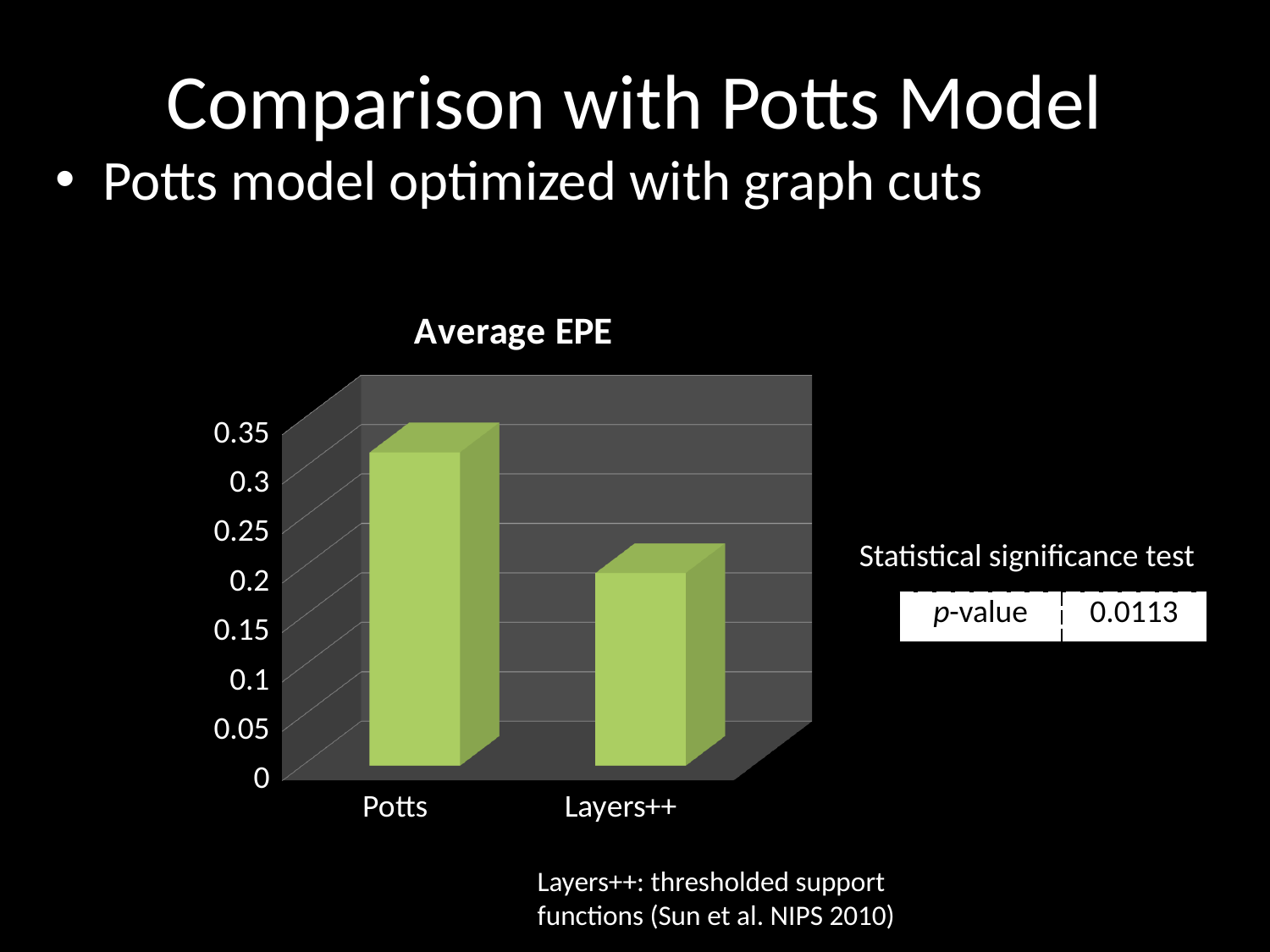
Which category has the lowest Average EPE? Layers++ What is the highest tick value shown on the vertical axis of the chart? 0.35 Is the Average EPE value for Layers++ greater or less than 0.15? greater Which category has the highest Average EPE? Potts Which has a larger Average EPE, Potts or Layers++? Potts Is the Average EPE value for Layers++ greater or less than 0.25? less What is the title of the chart? Average EPE Do the bar values rise or fall from Potts to Layers++ along the x axis? fall Is the Average EPE value for Potts greater or less than 0.3? greater How many categories are plotted in the Average EPE chart? 2 What kind of chart is shown on the slide? bar chart